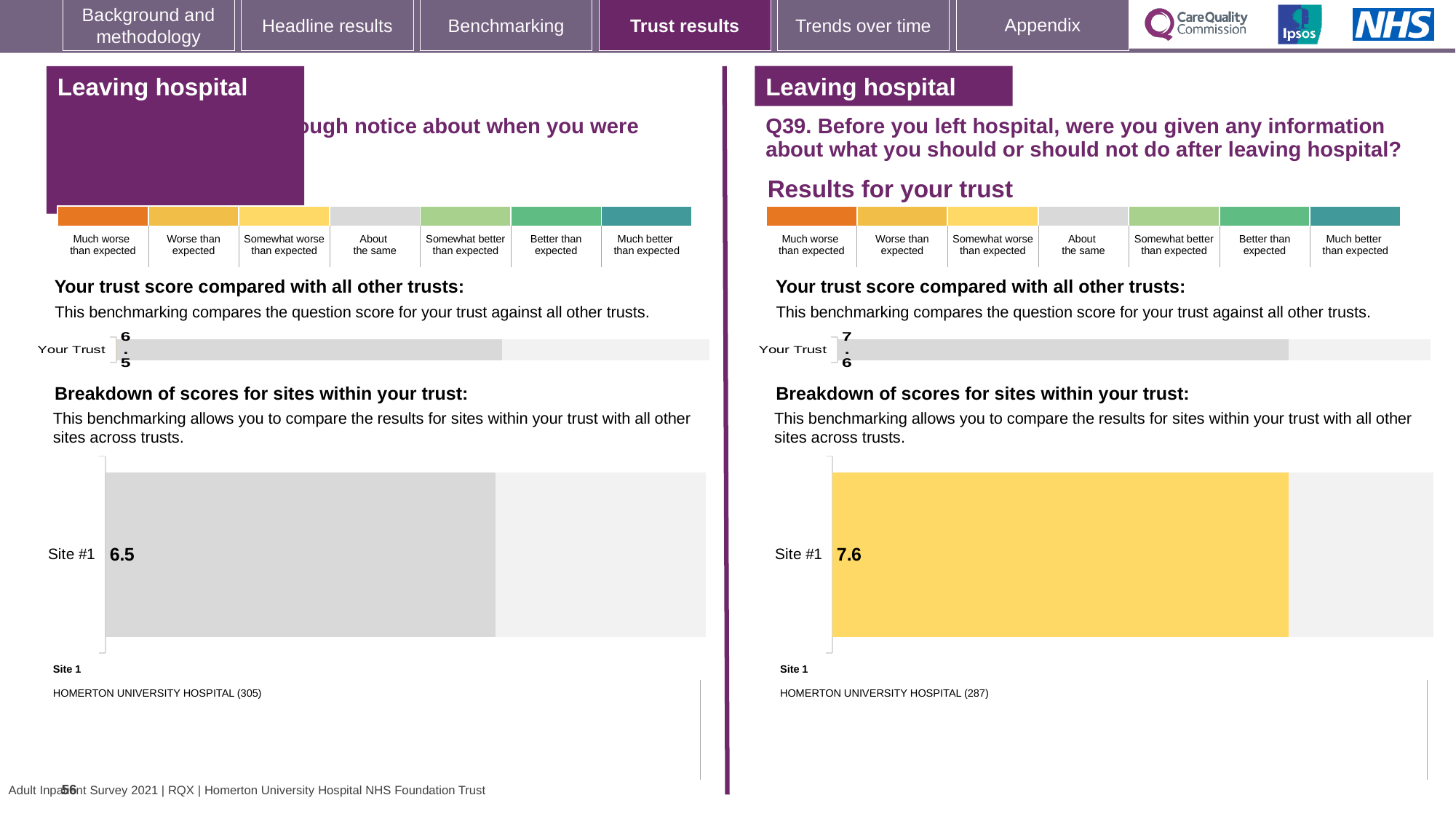
On the right-hand chart for Q39, what is the score shown for Your Trust? 7.6 On the left-hand site breakdown chart, what is the score for Site #1? 6.5 How many sites are shown in the site breakdown chart on the right-hand side for Q39? 1 Which is larger: the Site #1 score on the left-hand chart or the Site #1 score on the right-hand chart for Q39? Right-hand chart (Q39) On the left-hand site breakdown chart, what colour is the Site #1 bar? Grey What kind of chart is used to show the Site #1 score on the right-hand side for Q39? Bar chart On the right-hand site breakdown chart for Q39, what is the score for Site #1? 7.6 Is the Site #1 score on the left-hand chart equal to the Your Trust score on the left-hand chart? Yes What is the difference between the Site #1 score on the right-hand chart for Q39 and the Site #1 score on the left-hand chart? 1.1 Which site name is listed as Site 1 on the right-hand side for Q39? HOMERTON UNIVERSITY HOSPITAL (287) On the right-hand site breakdown chart for Q39, what colour is the Site #1 bar? Yellow On the left-hand chart, what is the score shown for Your Trust? 6.5